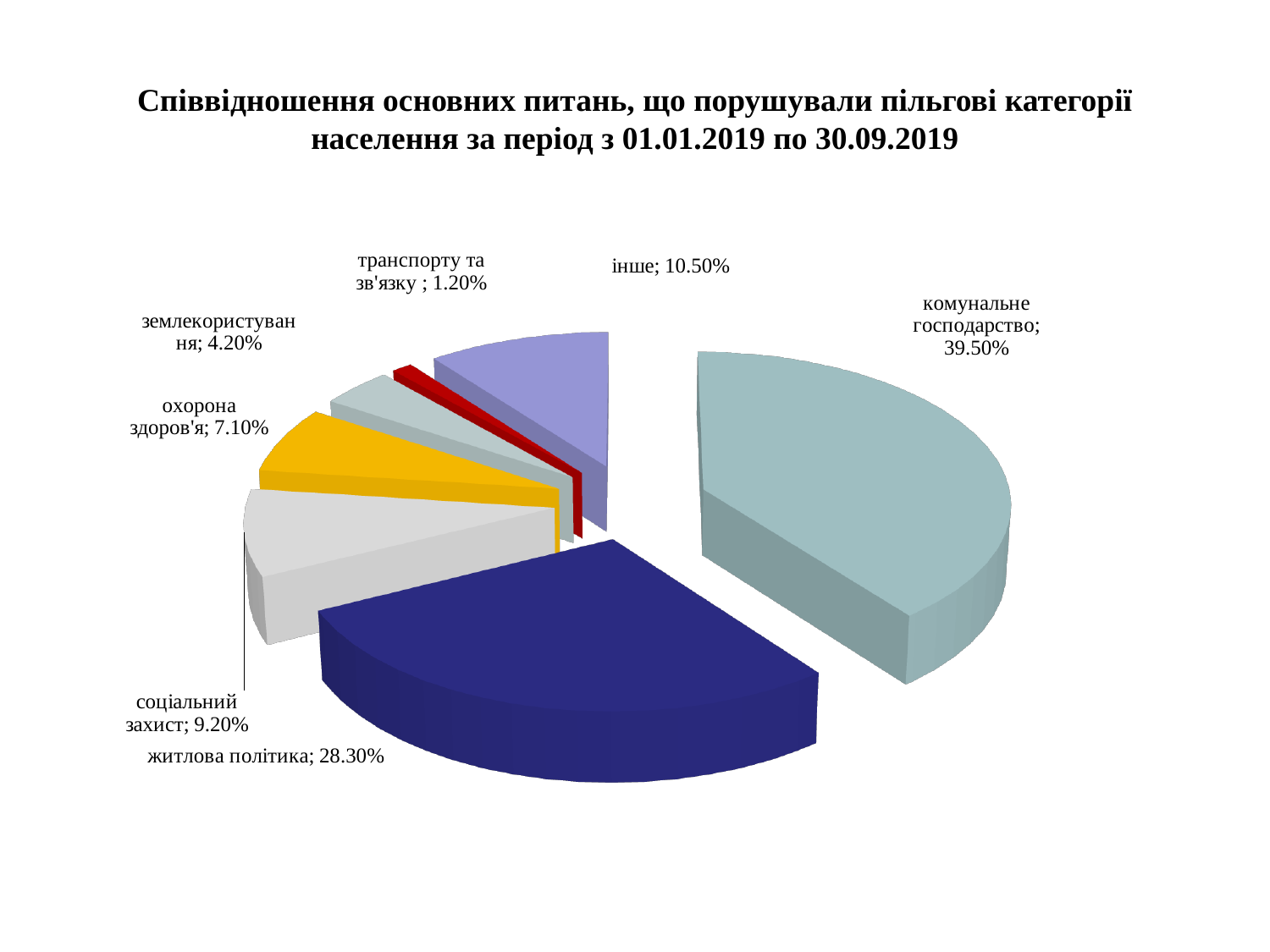
What period does the chart title say the data covers? з 01.01.2019 по 30.09.2019 What share of the pie does комунальне господарство have? 39.50% What kind of chart is shown on the slide? pie chart What is the value shown for житлова політика? 28.30% Which category has the largest slice of the pie? комунальне господарство Which is larger: the share for охорона здоров'я or the share for землекористування? охорона здоров'я How many categories are shown in the pie chart? 7 What is the value for транспорту та зв'язку? 1.20% Which category has the smallest slice of the pie? транспорту та зв'язку What percentage is shown for соціальний захист? 9.20% What is the difference between the shares of комунальне господарство and житлова політика? 11.20% What is the difference between the shares of інше and соціальний захист? 1.30%